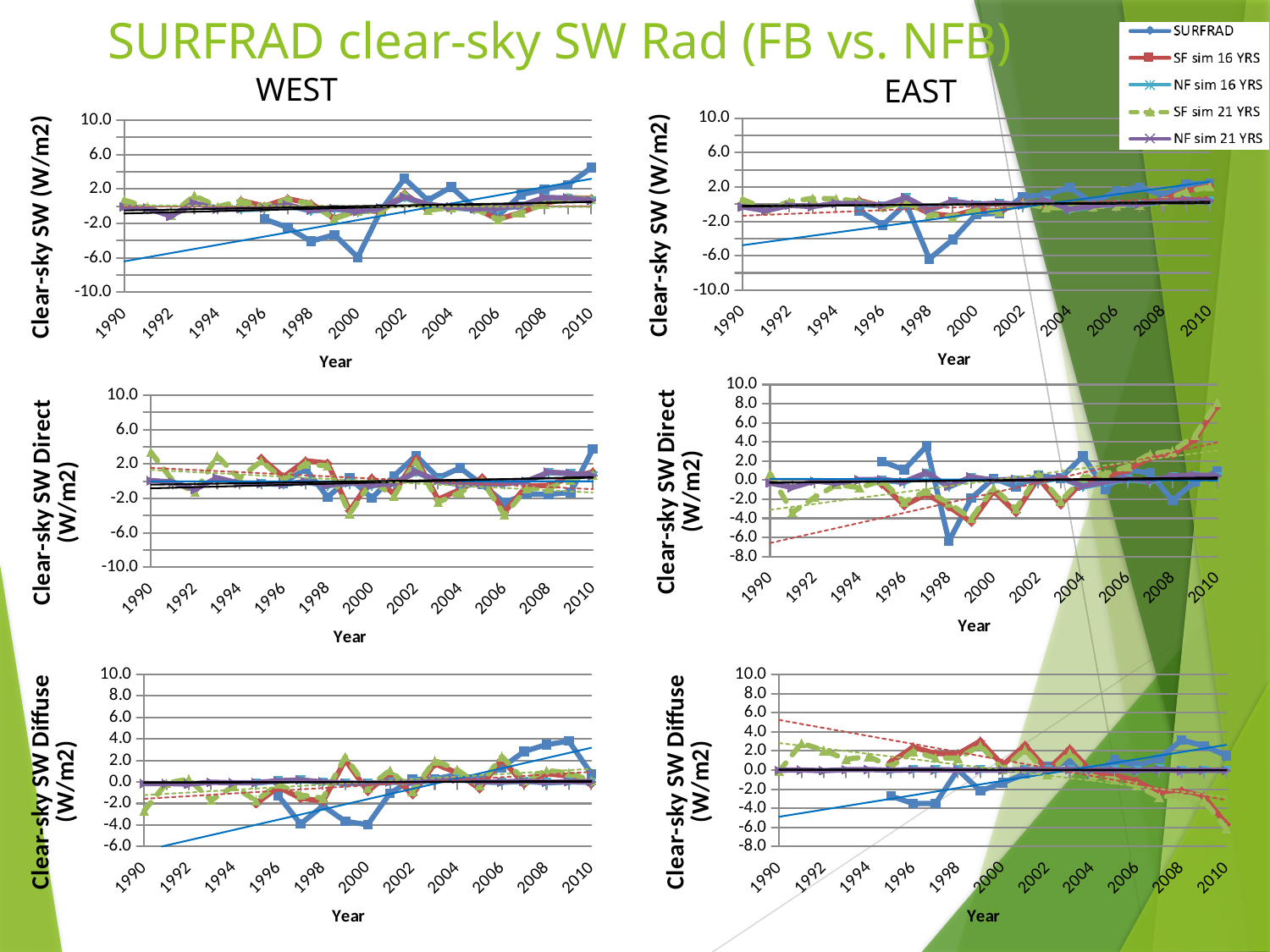
In the EAST Clear-sky SW chart (top right), is the SURFRAD value for 1998 greater or less than -2.0? less Which series in the legend is drawn with a blue line and diamond markers? SURFRAD How many charts are shown on the slide? 6 What is the x-axis title of the WEST Clear-sky SW Direct chart (middle left)? Year In the EAST Clear-sky SW Direct chart (middle right), is the SURFRAD value for 1998 greater or less than -4.0? less In the WEST Clear-sky SW Diffuse chart (bottom left), is the SURFRAD value for 2009 greater or less than 2.0? greater In the WEST Clear-sky SW chart (top left), does the SURFRAD series generally rise or fall from 1990 to 2010? rise What kind of chart is the WEST Clear-sky SW chart at the top left? line chart How many series does the legend at the top right of the slide list? 5 In the EAST Clear-sky SW Diffuse chart (bottom right), does the SURFRAD series generally rise or fall from 1996 to 2010? rise In the WEST Clear-sky SW chart (top left), how many year labels are shown on the x axis? 11